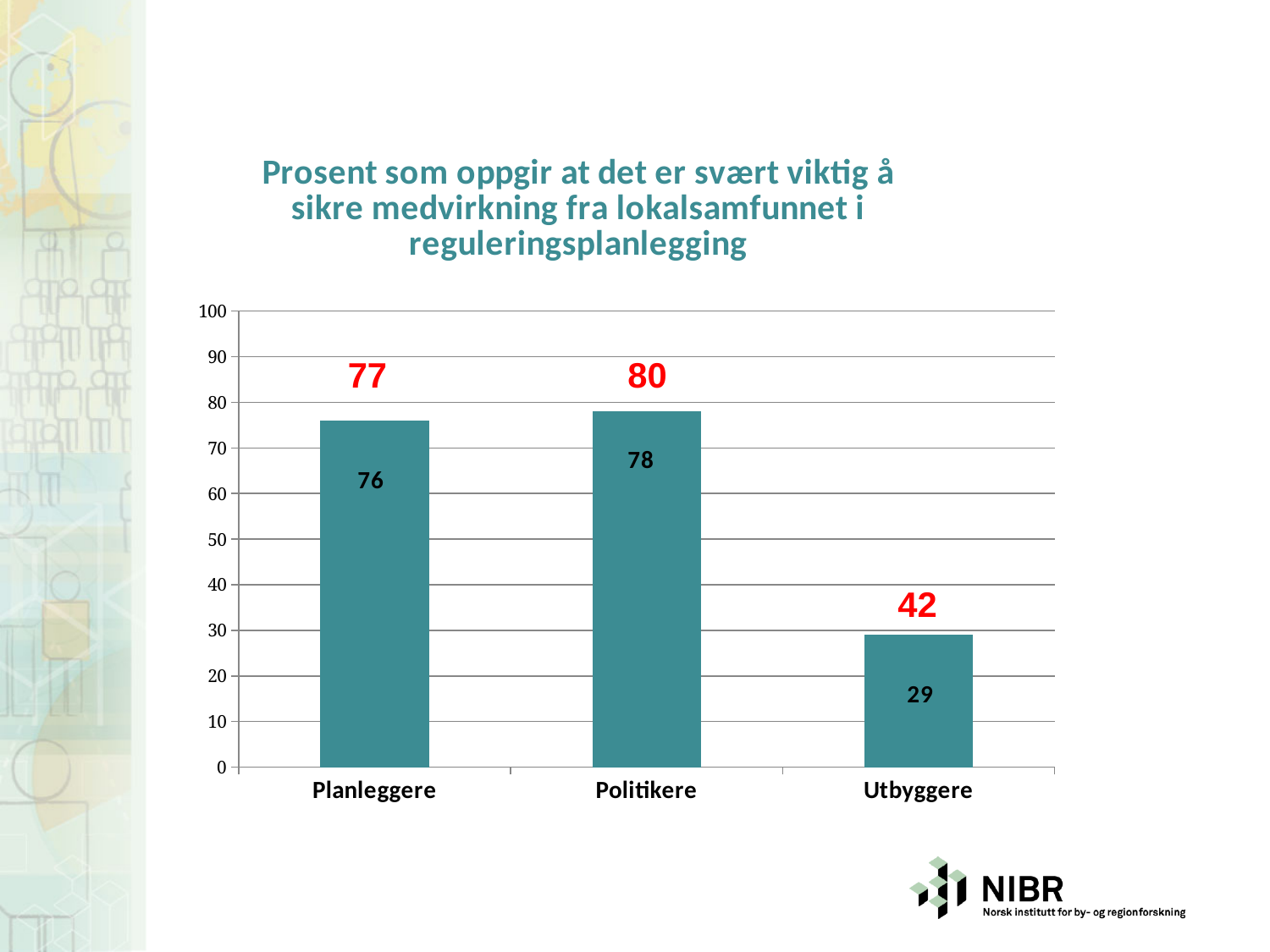
Is the bar for Utbyggere greater or less than 40? less What value is printed inside the bar for Politikere? 78 How many categories are shown on the x axis? 3 Using the values printed inside the bars, what is the difference between Politikere and Utbyggere? 49 Which bar is taller, Planleggere or Utbyggere? Planleggere What red number is printed above the bar for Utbyggere? 42 What value is printed inside the bar for Planleggere? 76 Which category has the shortest bar? Utbyggere Using the values printed inside the bars, what is the difference between Planleggere and Utbyggere? 47 What kind of chart is shown on the slide? bar chart Which category has the tallest bar? Politikere What value is printed inside the bar for Utbyggere? 29